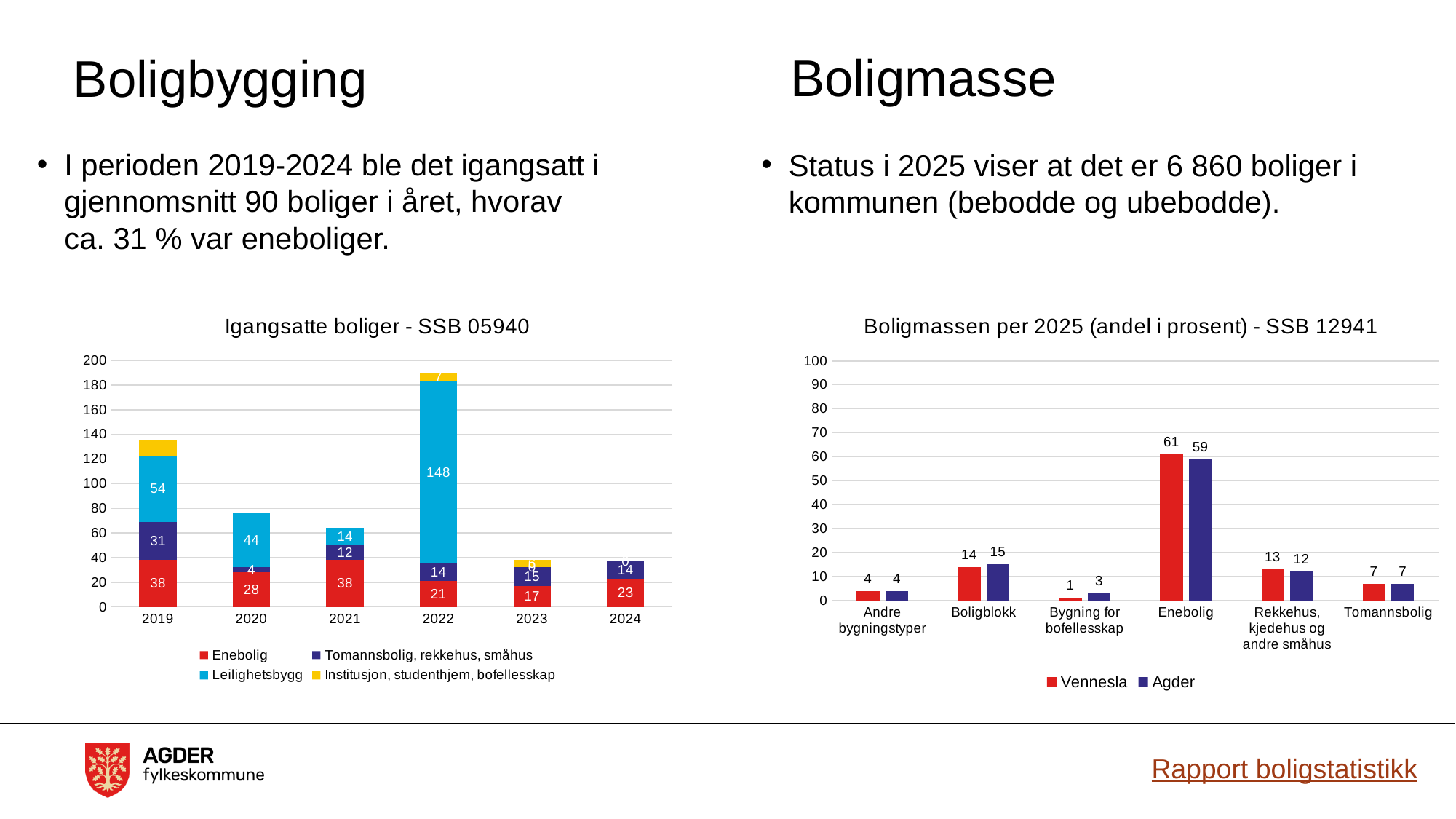
In the chart 'Igangsatte boliger - SSB 05940', which year has the tallest stacked bar? 2022 How many series does the legend of the chart 'Igangsatte boliger - SSB 05940' list? 4 How many categories are shown on the x axis of the chart 'Boligmassen per 2025 (andel i prosent) - SSB 12941'? 6 In the chart 'Igangsatte boliger - SSB 05940', what is the difference between the Enebolig values for 2019 and 2023? 21 In the chart 'Boligmassen per 2025 (andel i prosent) - SSB 12941', which category has the lowest value for Vennesla? Bygning for bofellesskap In the chart 'Igangsatte boliger - SSB 05940', what is the total of the stacked bar for 2021? 64 In the chart 'Igangsatte boliger - SSB 05940', what is the value for Leilighetsbygg in 2022? 148 What type of chart is 'Boligmassen per 2025 (andel i prosent) - SSB 12941'? Bar chart In the chart 'Boligmassen per 2025 (andel i prosent) - SSB 12941', which is larger for Boligblokk: Vennesla or Agder? Agder In the chart 'Boligmassen per 2025 (andel i prosent) - SSB 12941', what is the difference between Vennesla and Agder for Enebolig? 2 In the chart 'Igangsatte boliger - SSB 05940', what is the value for Enebolig in 2020? 28 In the chart 'Boligmassen per 2025 (andel i prosent) - SSB 12941', what is the value for Vennesla for Enebolig? 61